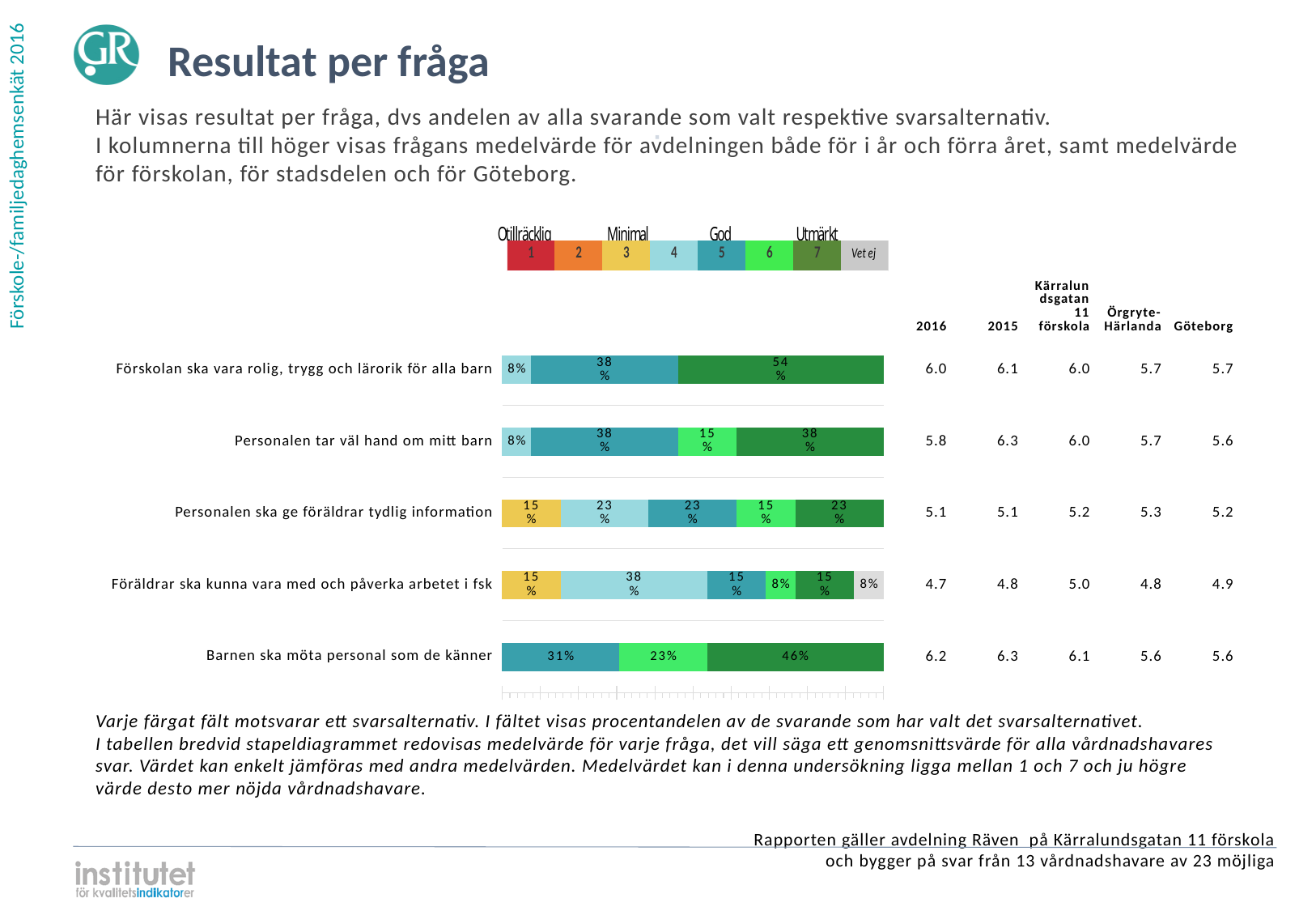
Which question has the largest share of respondents choosing answer 7 (dark green)? Förskolan ska vara rolig, trygg och lärorik för alla barn What kind of chart is used to show the results per question on this slide? Stacked bar chart How many questions (categories) are shown in the bar chart? 5 What percentage of respondents chose answer 6 (light green) for 'Personalen tar väl hand om mitt barn'? 15% What percentage of respondents answered 'Vet ej' for 'Föräldrar ska kunna vara med och påverka arbetet i fsk'? 8% Which is larger: the share choosing answer 7 for 'Barnen ska möta personal som de känner' or for 'Förskolan ska vara rolig, trygg och lärorik för alla barn'? Förskolan ska vara rolig, trygg och lärorik för alla barn Which answer category does the dark green colour represent in the legend? Utmärkt (7) What percentage of respondents chose answer 5 (teal) for 'Barnen ska möta personal som de känner'? 31% What percentage of respondents chose answer 7 (dark green) for 'Förskolan ska vara rolig, trygg och lärorik för alla barn'? 54% What is the difference in percentage points between the answer 7 share (54%) and the answer 5 share (38%) for 'Förskolan ska vara rolig, trygg och lärorik för alla barn'? 16 percentage points What is the 2016 mean value shown for 'Barnen ska möta personal som de känner'? 6.2 What percentage of respondents chose answer 3 (yellow) for 'Personalen ska ge föräldrar tydlig information'? 15%